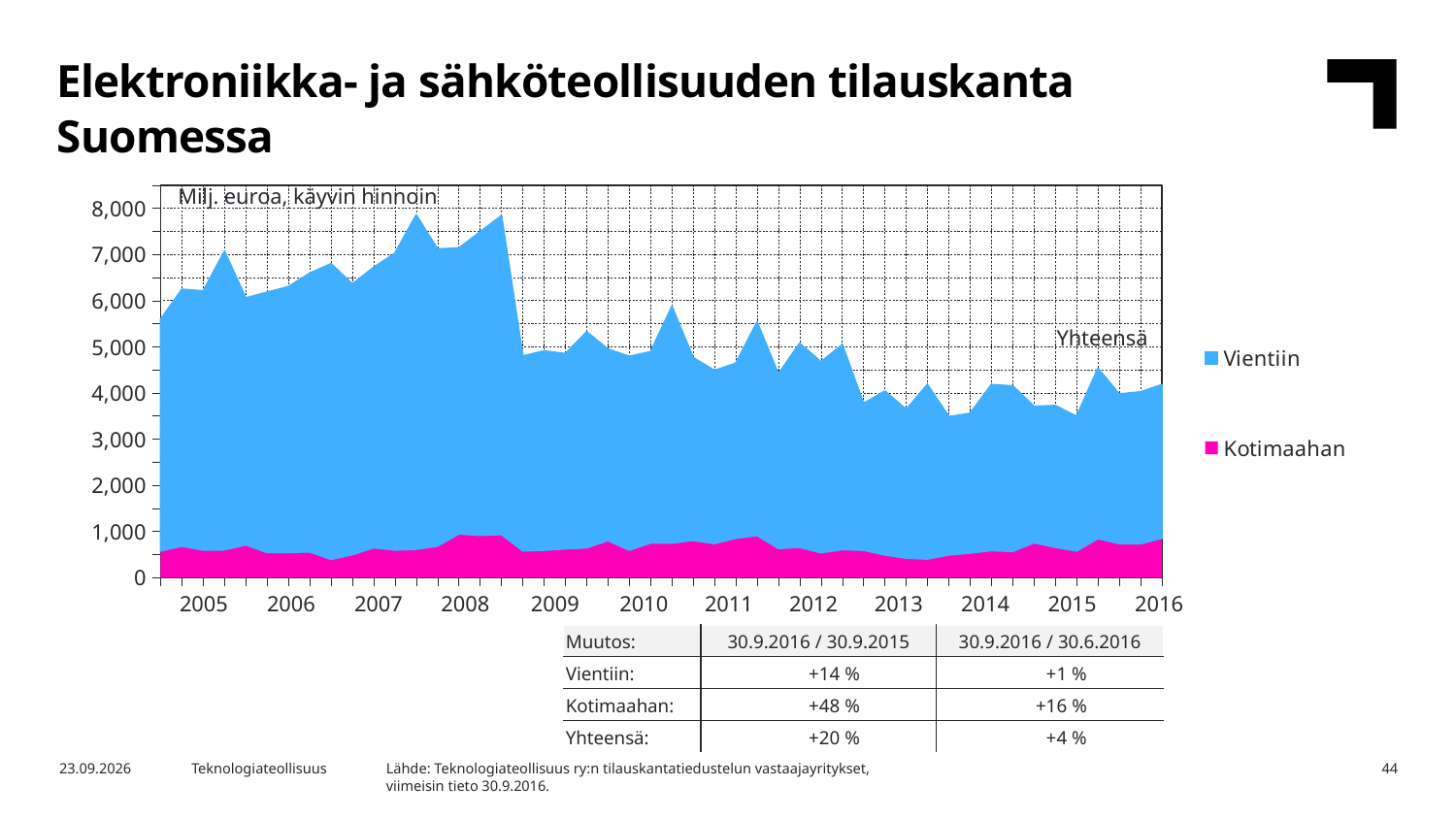
Is the total (Yhteensä) value at the end of 2016 greater or less than 5,000? less How many series does the chart legend list? 2 What kind of chart is shown on the slide? Stacked area chart Is the total (Yhteensä) value at the start of 2005 greater or less than 5,000? greater What is the highest value shown on the y axis of the chart? 8,000 How many years are labelled on the x axis of the chart? 12 What are the two series named in the chart legend? Vientiin and Kotimaahan Is the Kotimaahan value in 2016 greater or less than 1,000? less Which series occupies the larger area of the chart, Vientiin or Kotimaahan? Vientiin Does the total order book (Yhteensä) rise or fall between 2008 and 2016? fall What unit label is printed at the top of the chart? Milj. euroa, käyvin hinnoin